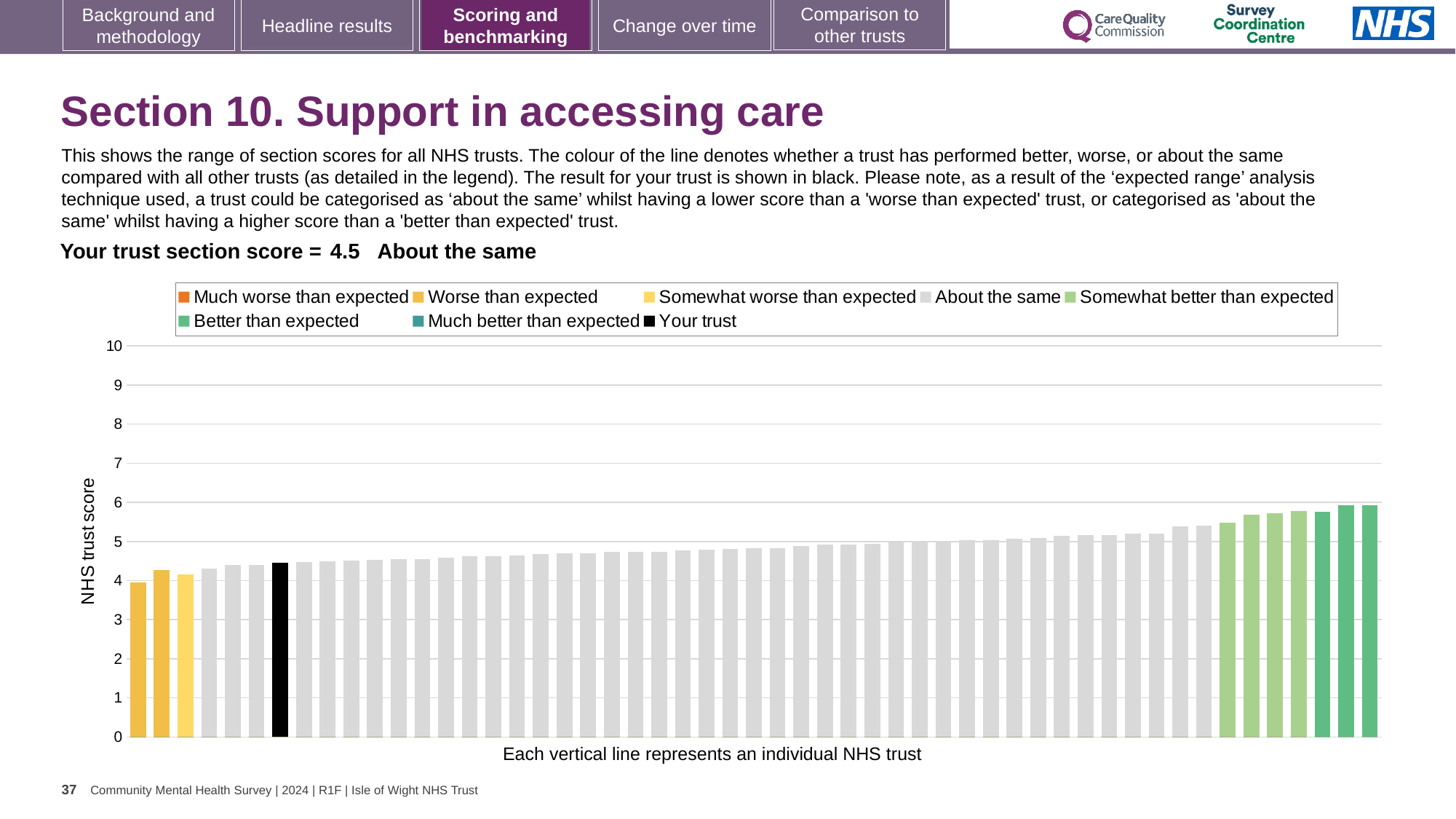
How many entries does the chart legend list? 8 What is the section score for your trust? 4.5 How many bars are coloured as 'Somewhat better than expected' (light green)? 4 Is the value of the highest bar greater or less than 7? less What is the label on the vertical axis of the chart? NHS trust score Which is larger: the value of the leftmost bar or the value of your trust's black bar? your trust's black bar Is the value for your trust (the black bar) greater or less than 5? less How many bars are coloured as 'Worse than expected' (yellow)? 2 What colour is the bar representing your trust? black What kind of chart is shown on the slide? bar chart Is the value of the highest bar greater or less than 5? greater Do the bar values rise or fall from left to right along the x axis? rise